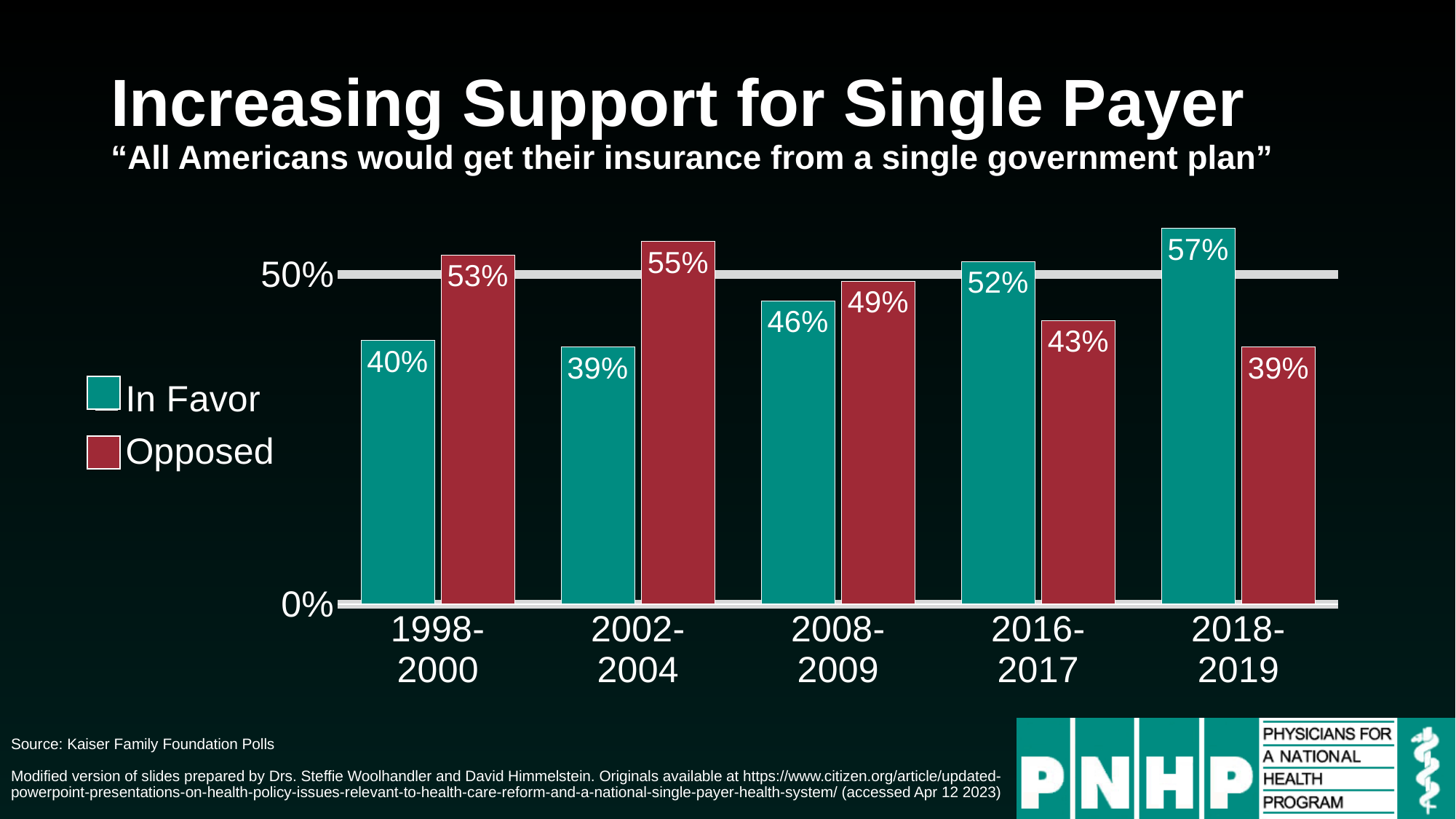
Does the In Favor value generally rise or fall from 1998-2000 to 2018-2019? rise What percentage was Opposed in 2002-2004? 55% Is the In Favor value for 2002-2004 greater or less than 50%? less What percentage was In Favor in 1998-2000? 40% In which period was the Opposed value lowest? 2018-2019 What kind of chart is shown on the slide? bar chart What percentage was In Favor in 2018-2019? 57% In which period was the In Favor value highest? 2018-2019 What is the difference between the In Favor and Opposed values in 2016-2017? 9% How many time periods are shown on the x axis? 5 In 2008-2009, which was larger, In Favor or Opposed? Opposed How many series does the legend list? 2